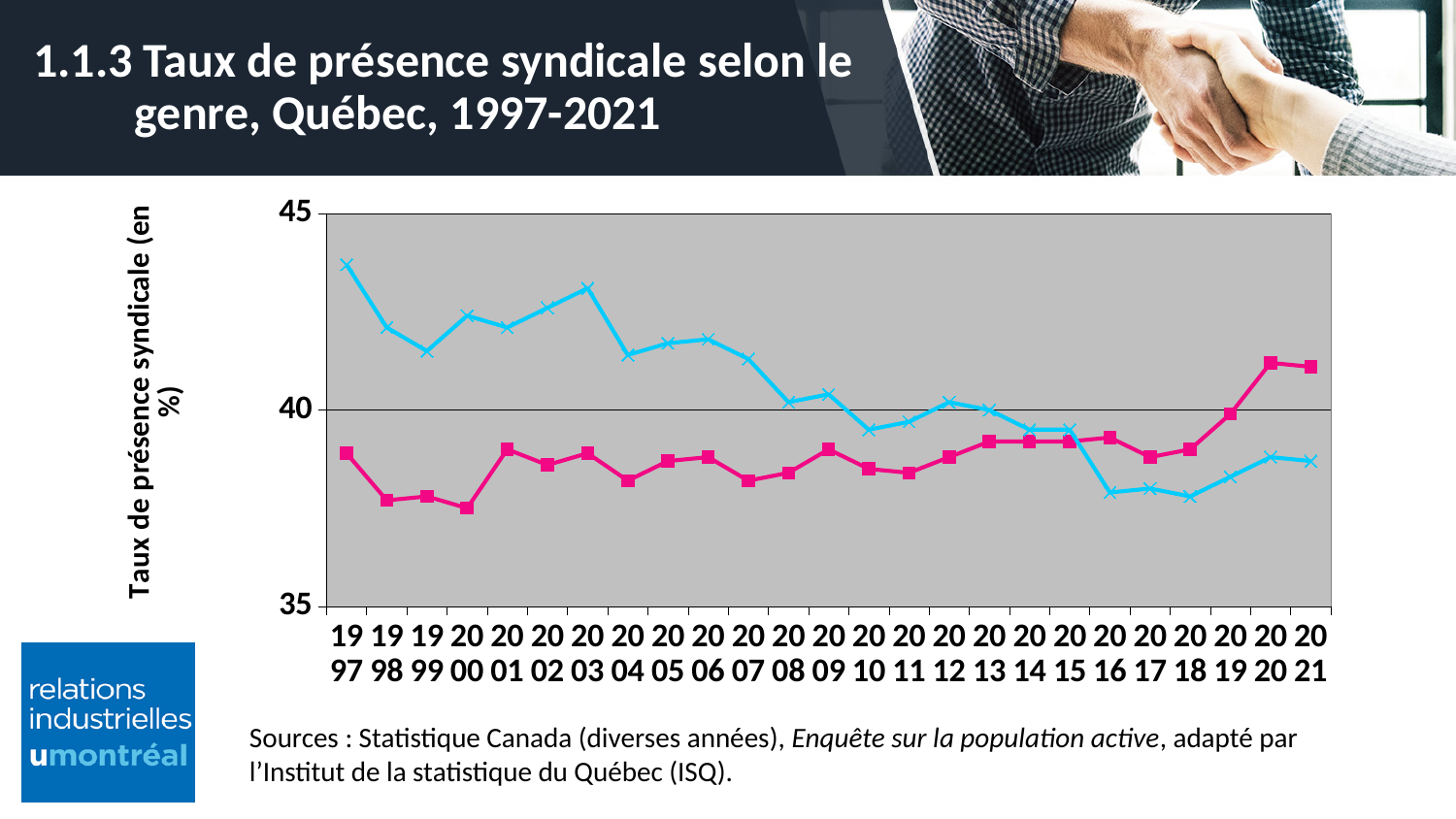
How many years are plotted along the x axis of the chart? 25 Does the blue line overall rise or fall from 1997 to 2021? fall Is the value of the blue line in 2021 greater or less than 40? less In 2021, which line has the higher value, the blue line or the pink line? the pink line In 1997, which line has the higher value, the blue line or the pink line? the blue line Is the value of the blue line in 1997 greater or less than 40? greater In which year does the blue line reach its highest value? 1997 What kind of chart is shown on the slide? line chart What is the title of the chart on the slide? 1.1.3 Taux de présence syndicale selon le genre, Québec, 1997-2021 What is the label of the vertical axis of the chart? Taux de présence syndicale (en %) Is the value of the pink line in 2021 greater or less than 40? greater